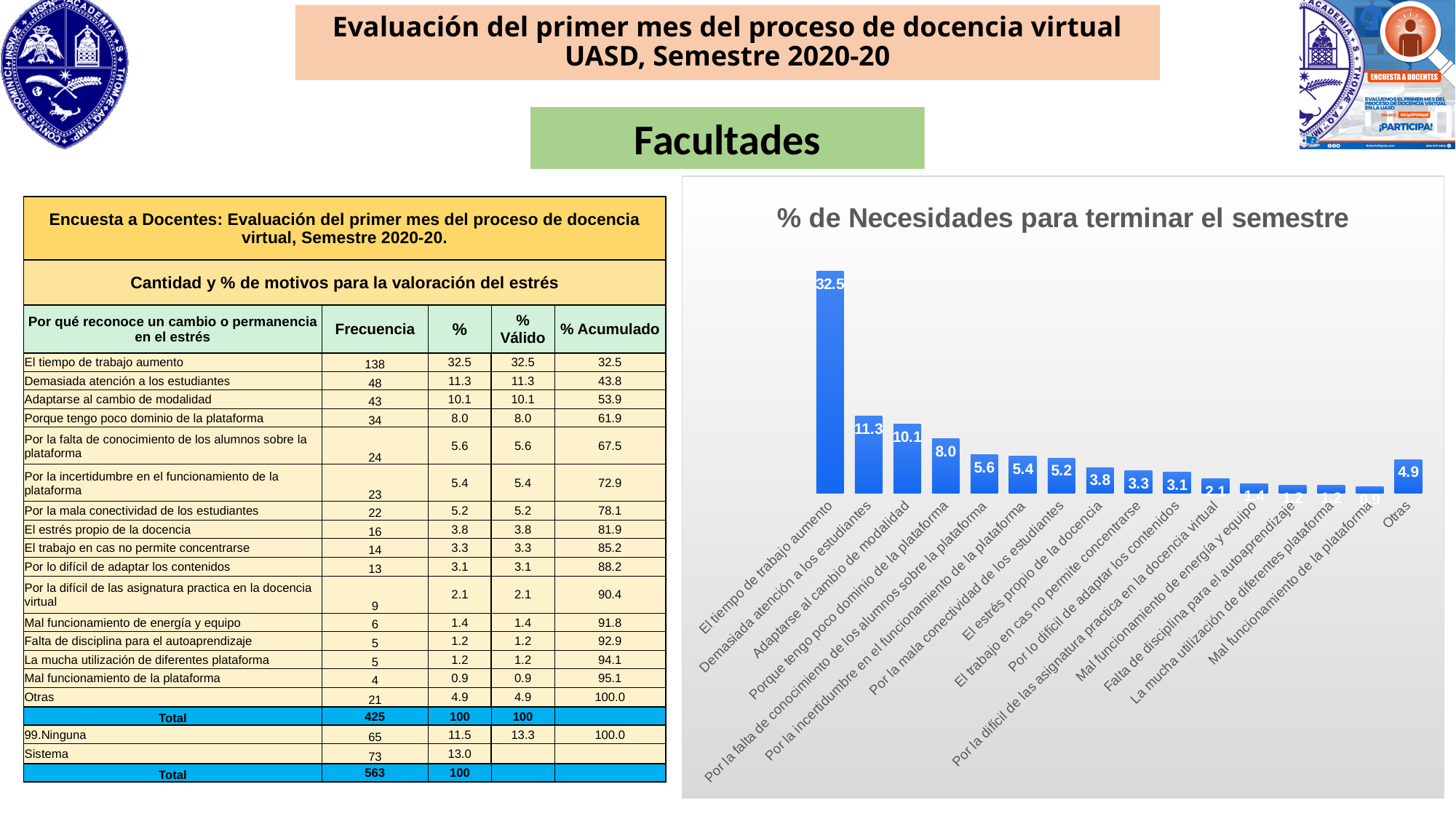
Which category has the lowest value? Mal funcionamiento de la plataforma What is the value for "Otras"? 4.9 How many categories are shown in the chart? 16 What is the value for "Demasiada atención a los estudiantes"? 11.3 What is the value for "El tiempo de trabajo aumento"? 32.5 What type of chart is shown on the slide? bar chart What is the difference between the values for "El tiempo de trabajo aumento" and "Demasiada atención a los estudiantes"? 21.2 What is the value for "Porque tengo poco dominio de la plataforma"? 8.0 What is the title of the chart? % de Necesidades para terminar el semestre Which category has the highest value? El tiempo de trabajo aumento Which is larger, the value for "Adaptarse al cambio de modalidad" or the value for "Otras"? Adaptarse al cambio de modalidad What is the difference between the values for "Por la mala conectividad de los estudiantes" and "El estrés propio de la docencia"? 1.4